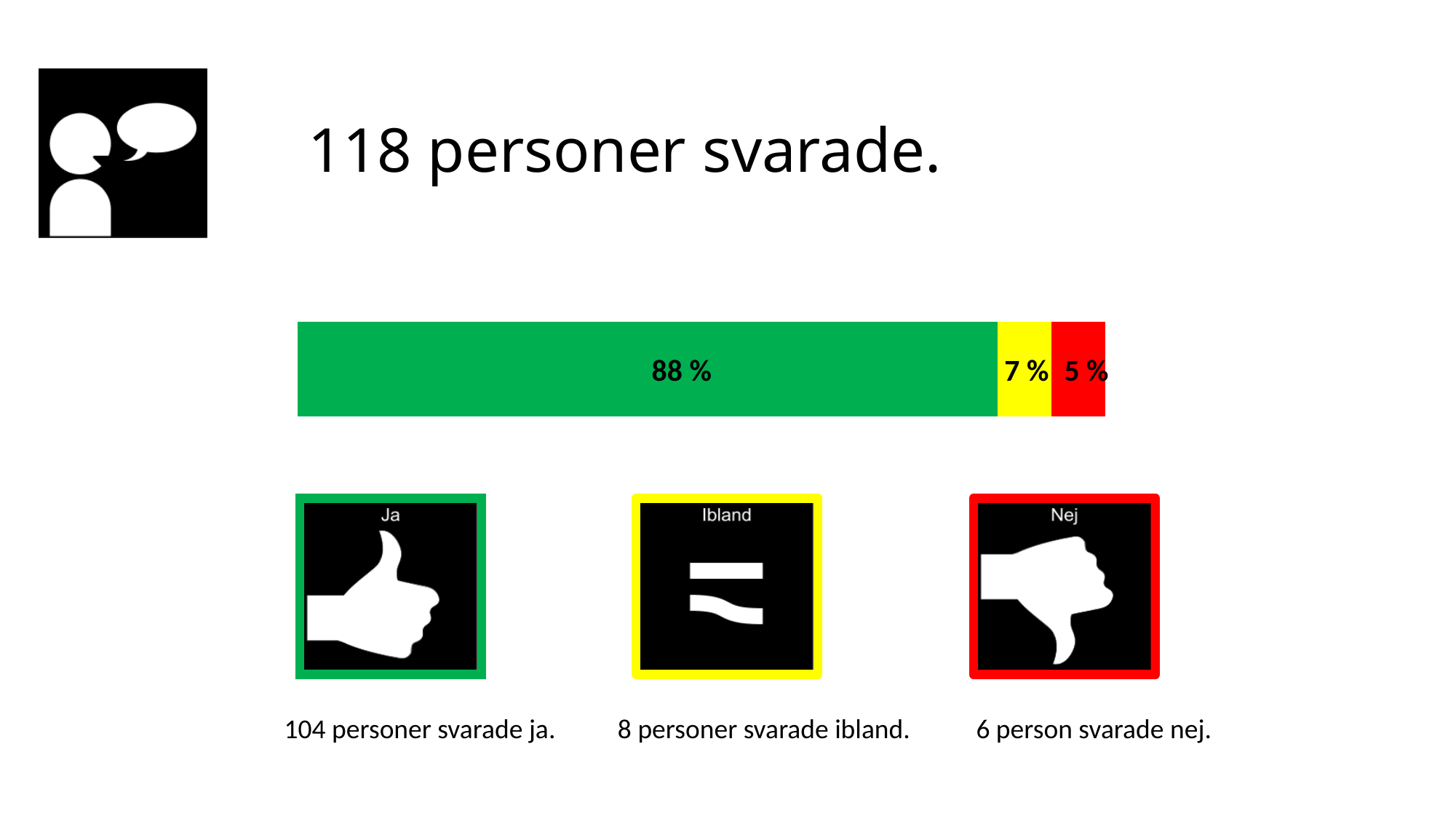
What is the difference between the yellow segment and the red segment of the bar? 2 % What percentage is shown on the green segment of the bar? 88 % What is the total of all segments in the stacked bar? 100 % Which segment of the bar has the smallest share? 5 % (red, Nej) What percentage is shown on the red segment of the bar? 5 % What percentage is shown on the yellow segment of the bar? 7 % Which is larger, the yellow segment or the red segment of the bar? The yellow segment (7 %) What is the difference between the green segment and the yellow segment of the bar? 81 % Which segment of the bar has the largest share? 88 % (green, Ja) What kind of chart is shown on the slide? A stacked bar chart How many segments does the stacked bar have? 3 What colour is the segment labelled 88 %? Green